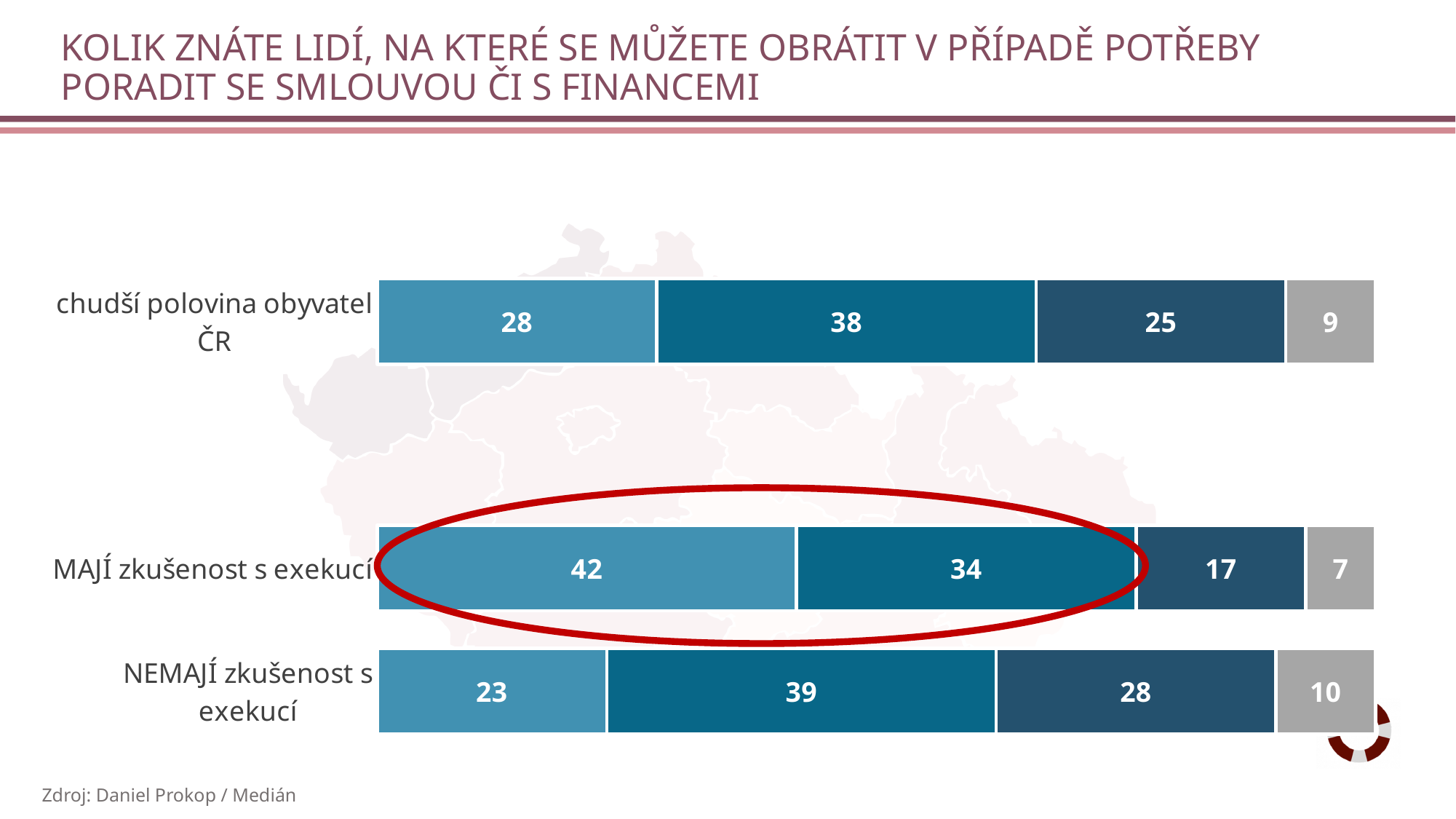
Which bar is highlighted with a red oval on the slide? MAJÍ zkušenost s exekucí What is the total of the stacked bar for 'chudší polovina obyvatel ČR'? 100 Which is larger: the second segment for 'NEMAJÍ zkušenost s exekucí' or the second segment for 'MAJÍ zkušenost s exekucí'? NEMAJÍ zkušenost s exekucí What is the value of the grey (rightmost) segment for 'NEMAJÍ zkušenost s exekucí'? 10 What is the value of the second segment for 'chudší polovina obyvatel ČR'? 38 What is the value of the first (leftmost, light blue) segment for 'MAJÍ zkušenost s exekucí'? 42 What type of chart is shown on the slide? stacked bar chart Which category has the lowest value in the grey (rightmost) segment? MAJÍ zkušenost s exekucí How many categories (bars) does the chart show? 3 What is the difference between the first segment values of 'MAJÍ zkušenost s exekucí' and 'NEMAJÍ zkušenost s exekucí'? 19 Which category has the highest value in the first (leftmost) segment? MAJÍ zkušenost s exekucí What is the value of the third (dark blue) segment for 'MAJÍ zkušenost s exekucí'? 17